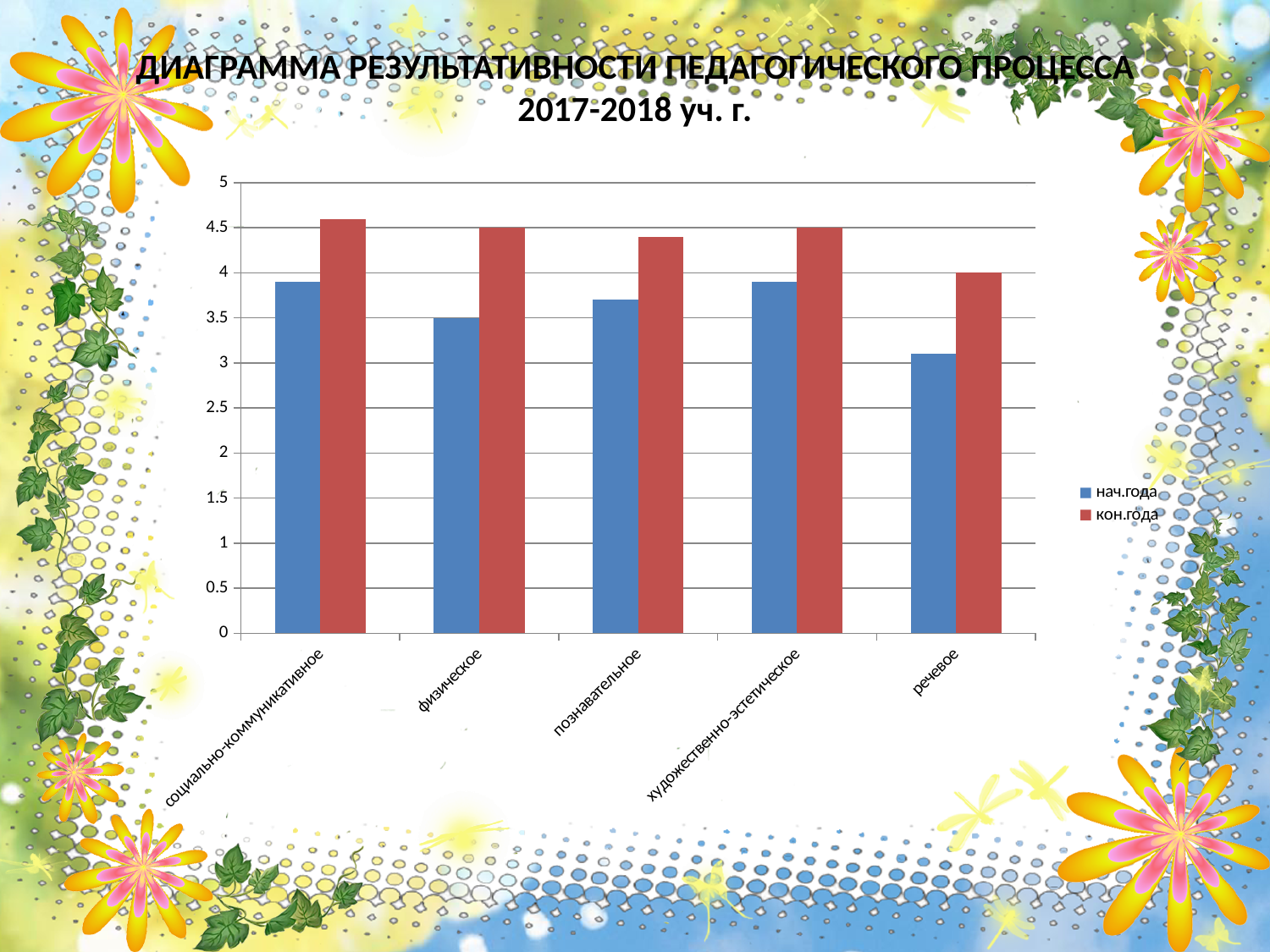
What is the кон.года value for физическое? 4.5 For речевое, which is larger: the нач.года value or the кон.года value? кон.года Is the нач.года value for социально-коммуникативное greater or less than 4? less What is the кон.года value for речевое? 4 How many series does the chart legend list? 2 What are the two series named in the chart legend? нач.года and кон.года What is the нач.года value for физическое? 3.5 Is the кон.года value for познавательное greater or less than 4? greater Which category has the lowest нач.года value? речевое Which category has the lowest кон.года value? речевое How many categories are shown on the x axis of the chart? 5 What kind of chart is shown on the slide? bar chart